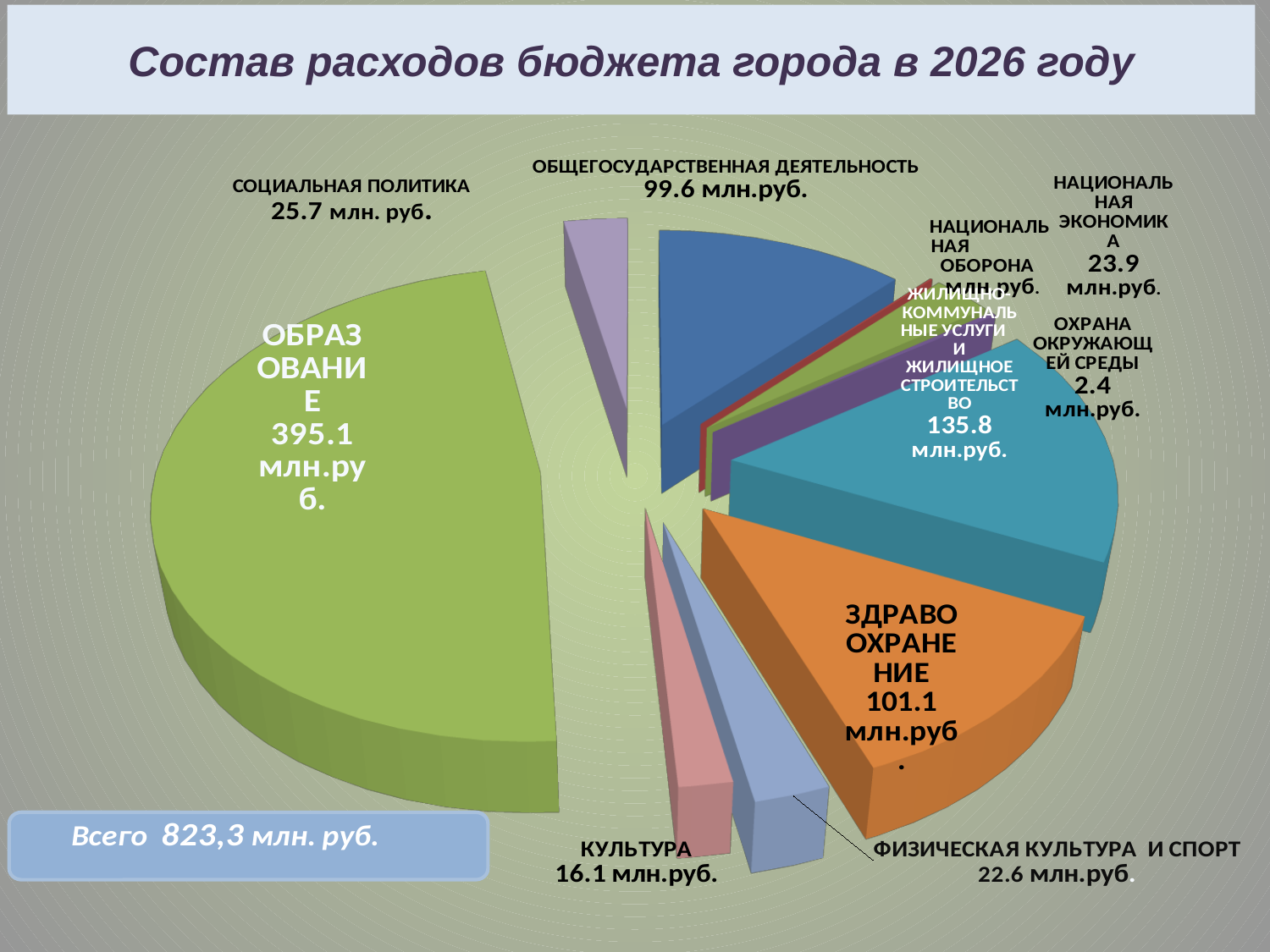
What is the difference between Жилищно-коммунальные услуги и жилищное строительство and Здравоохранение? 34.7 млн.руб. What is the value for Культура? 16.1 млн.руб. What is the total of all budget expenditures shown on the slide? 823,3 млн. руб. What is the value for Охрана окружающей среды? 2.4 млн.руб. What kind of chart is shown on the slide? Pie chart Which category has the largest share of the budget expenditures? Образование What is the title of the chart? Состав расходов бюджета города в 2026 году What is the value for Жилищно-коммунальные услуги и жилищное строительство? 135.8 млн.руб. What is the value for Образование? 395.1 млн.руб. What is the difference between Физическая культура и спорт and Культура? 6.5 млн.руб. What is the value for Здравоохранение? 101.1 млн.руб. Which is larger, Общегосударственная деятельность or Здравоохранение? Здравоохранение